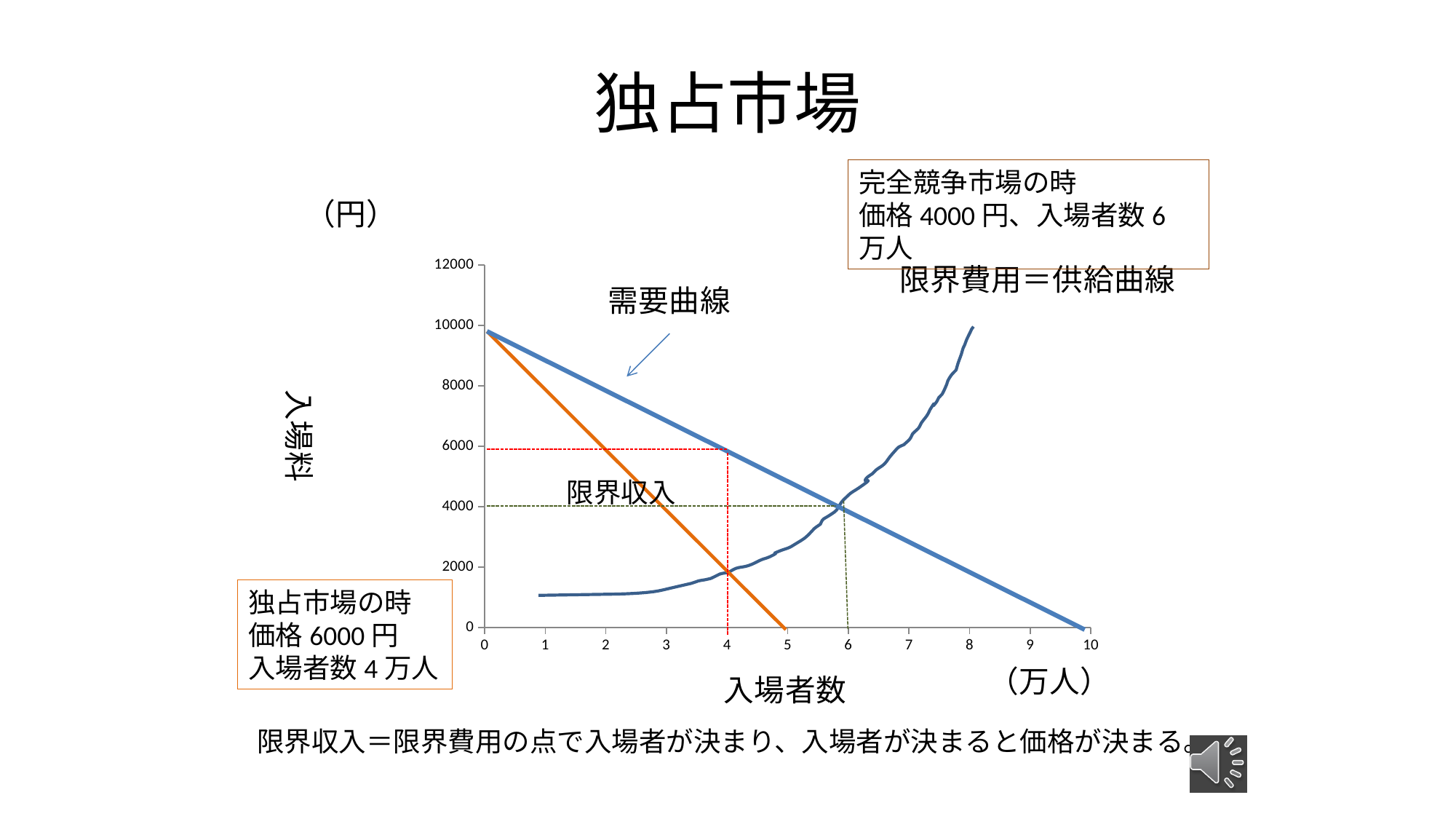
According to the slide, what is the number of attendees (入場者数) in the perfectly competitive market (完全競争市場の時)? 6万人 According to the slide, what is the number of attendees (入場者数) in the monopoly market (独占市場の時)? 4万人 According to the slide, what is the price (価格) in the monopoly market (独占市場の時)? 6000円 What is the label of the horizontal axis of the chart? 入場者数 What kind of chart is shown on the slide? line chart Does the 需要曲線 (demand curve) rise or fall as 入場者数 increases along the x axis? fall What is the title of the slide containing the chart? 独占市場 According to the slide, what is the price (価格) in the perfectly competitive market (完全競争市場の時)? 4000円 Does the 限界費用＝供給曲線 rise or fall as 入場者数 increases along the x axis? rise Is the value of the 限界費用＝供給曲線 at 入場者数 = 2 greater or less than 2000? less How many curves are plotted on the chart? 3 Is the value of the 需要曲線 at 入場者数 = 0 greater or less than 8000? greater